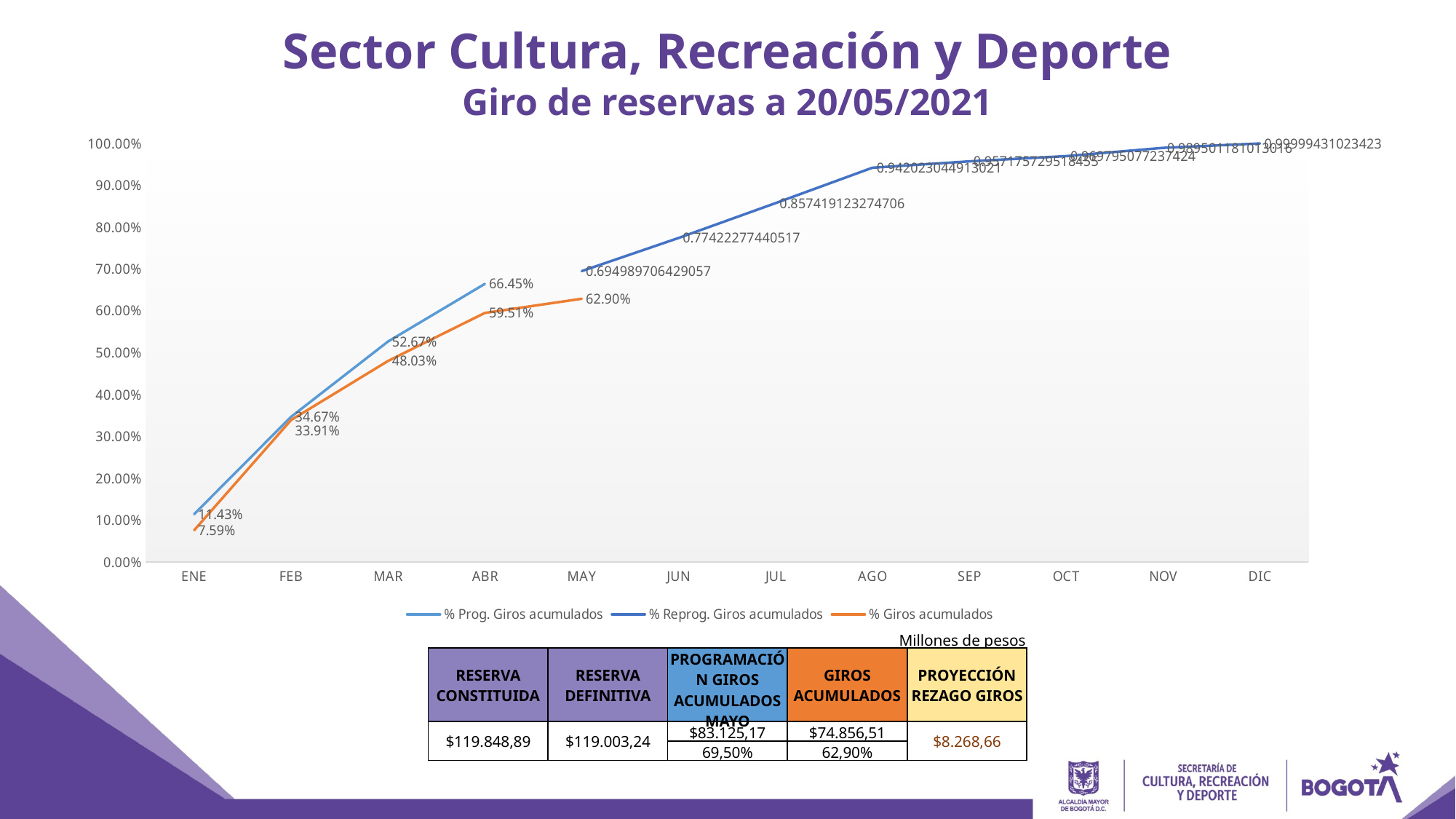
In MAR, which is higher: % Prog. Giros acumulados or % Giros acumulados? % Prog. Giros acumulados What is the value of % Reprog. Giros acumulados in DIC? 0.99999431023423 Does the % Giros acumulados line rise or fall from ENE to MAY? Rises Is the value of % Reprog. Giros acumulados in JUL greater or less than 80.00%? greater How many months are shown on the x axis of the chart? 12 What type of chart is shown on the slide? Line chart What is the difference between % Prog. Giros acumulados and % Giros acumulados in ABR? 6.94 percentage points What is the value of % Prog. Giros acumulados in ABR? 66.45% What is the value of % Giros acumulados in MAY? 62.90% What is the value of % Giros acumulados in ENE? 7.59% How many series does the chart legend list? 3 Which colour is used for the % Giros acumulados series in the chart? Orange